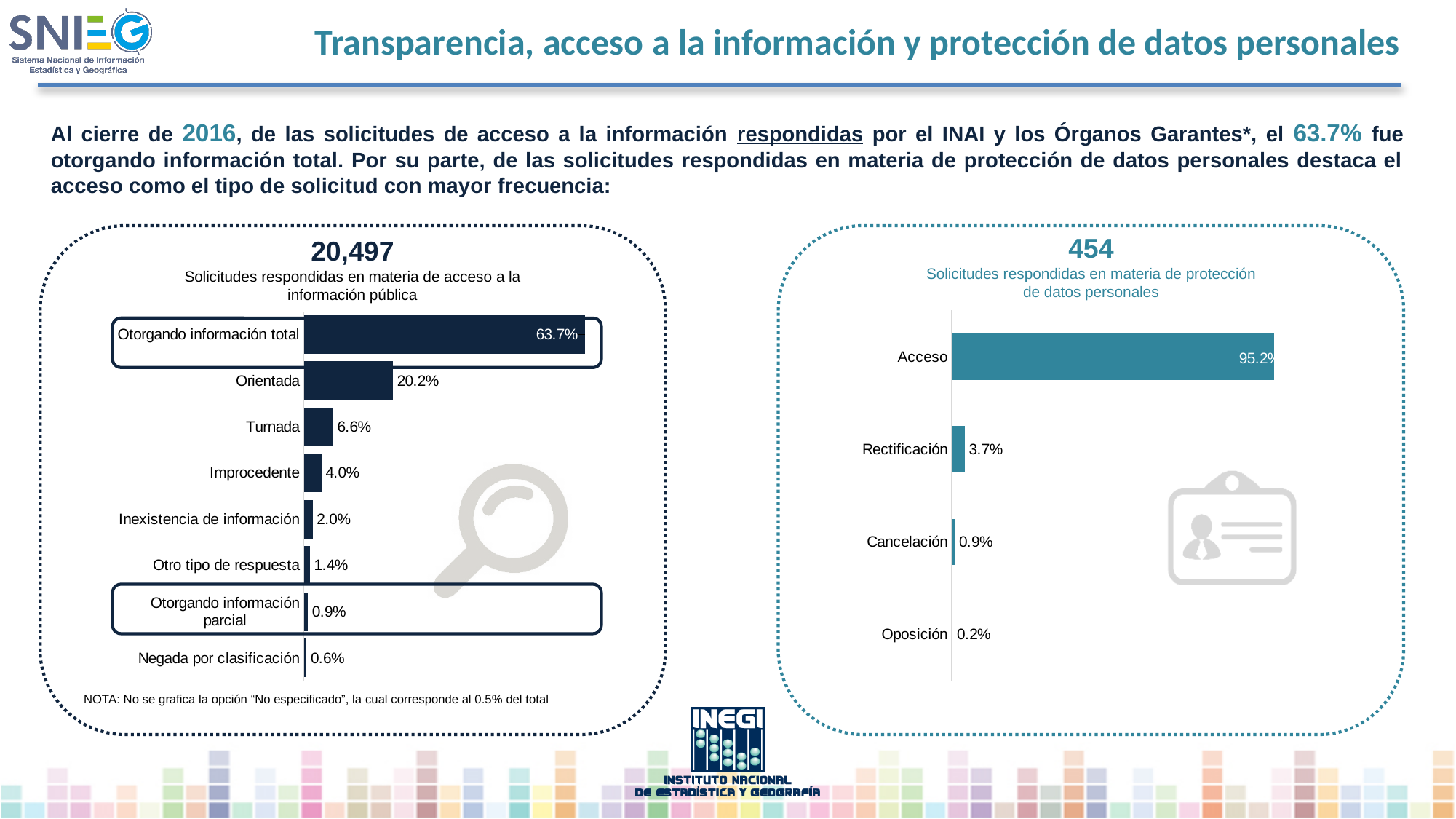
What kind of chart is the right chart (Solicitudes respondidas en materia de protección de datos personales)? Bar chart In the left chart (Solicitudes respondidas en materia de acceso a la información pública), what is the difference between Otorgando información total and Orientada? 43.5% In the left chart (Solicitudes respondidas en materia de acceso a la información pública), how many categories are plotted? 8 In the left chart (Solicitudes respondidas en materia de acceso a la información pública), which category has the highest value? Otorgando información total In the left chart (Solicitudes respondidas en materia de acceso a la información pública), what is the value for Inexistencia de información? 2.0% In the right chart (Solicitudes respondidas en materia de protección de datos personales), what is the difference between Acceso and Rectificación? 91.5% In the right chart (Solicitudes respondidas en materia de protección de datos personales), how many categories are plotted? 4 In the left chart (Solicitudes respondidas en materia de acceso a la información pública), what is the value for Orientada? 20.2% In the left chart (Solicitudes respondidas en materia de acceso a la información pública), which category has the lowest value? Negada por clasificación In the right chart (Solicitudes respondidas en materia de protección de datos personales), which category has the highest value? Acceso In the right chart (Solicitudes respondidas en materia de protección de datos personales), which category has the lowest value? Oposición In the right chart (Solicitudes respondidas en materia de protección de datos personales), what is the value for Rectificación? 3.7%